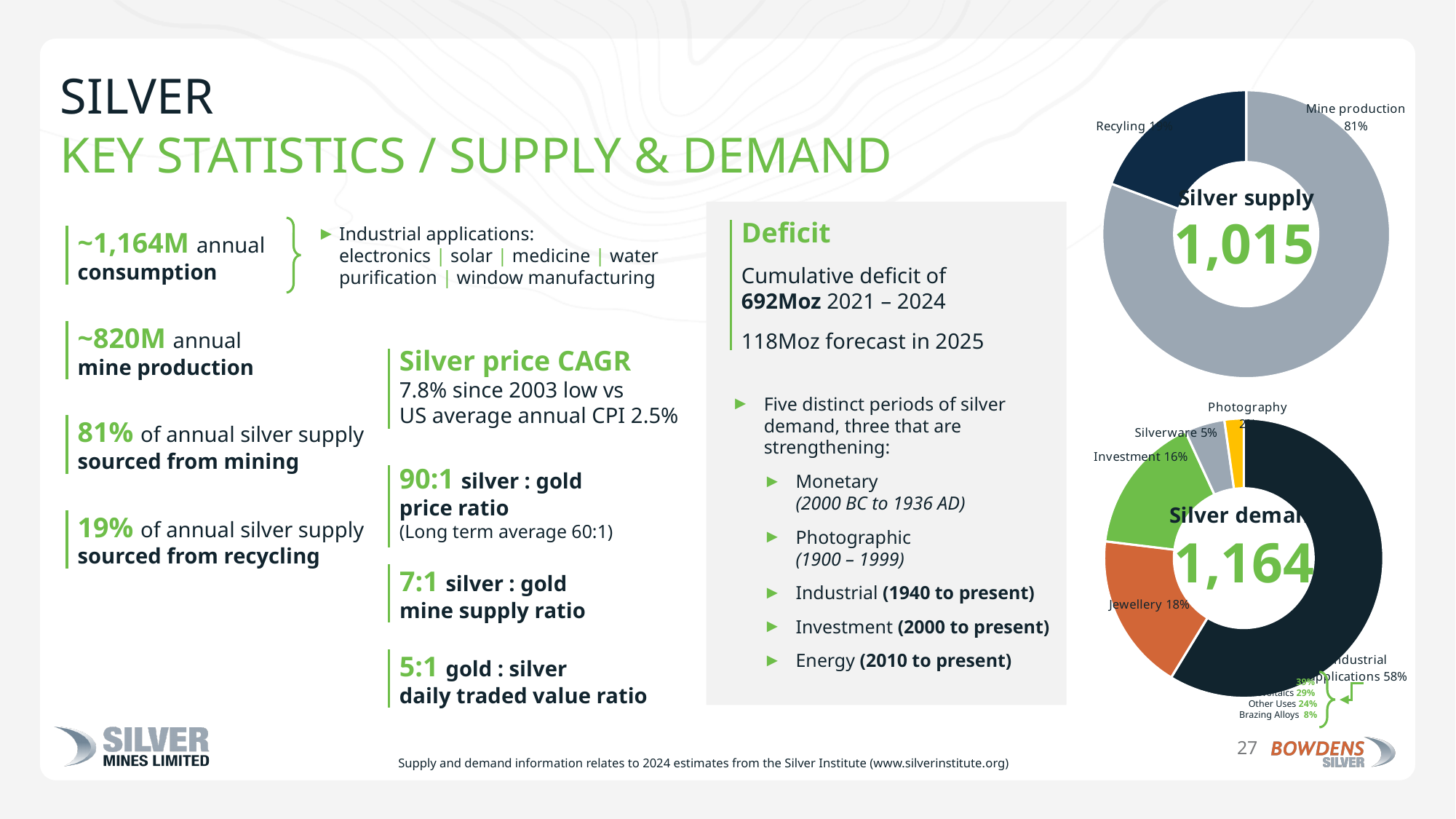
What kind of chart is the Silver supply chart? doughnut chart In the Silver demand chart, what share is Investment? 16% In the Silver demand chart, what share is Silverware? 5% In the Silver demand chart, how many percentage points larger is Jewellery than Investment? 2 In the Silver supply chart, what share of supply comes from Mine production? 81% In the Silver supply chart, which category has the largest slice? Mine production In the Silver demand chart, what share is Jewellery? 18% What total value is shown in the centre of the Silver demand chart? 1,164 What total value is shown in the centre of the Silver supply chart? 1,015 In the Silver demand chart, which is larger, Jewellery or Investment? Jewellery In the Silver demand chart, what share is Industrial applications? 58% In the Silver demand chart, which category has the largest slice? Industrial applications